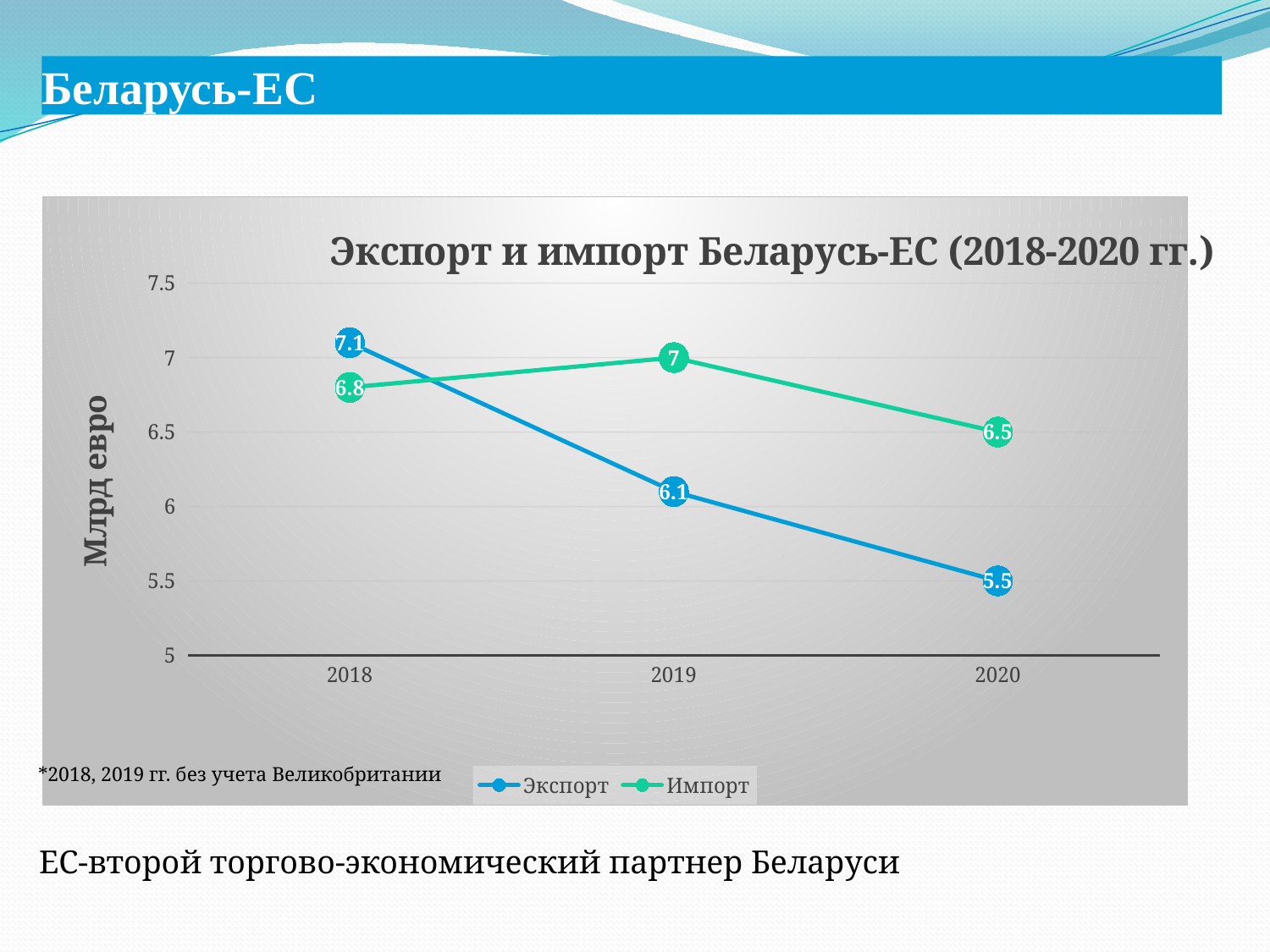
What is the value of Экспорт in 2018? 7.1 Which is larger in 2018, Экспорт or Импорт? Экспорт What is the value of Импорт in 2019? 7 What is the value of Импорт in 2020? 6.5 What is the value of Экспорт in 2020? 5.5 In which year is Экспорт highest? 2018 What is the difference between Импорт and Экспорт in 2020? 1 How many years are shown on the x axis? 3 What kind of chart is this? line chart In which year is Импорт lowest? 2020 Does Экспорт rise or fall from 2018 to 2020? fall How many series does the legend list? 2